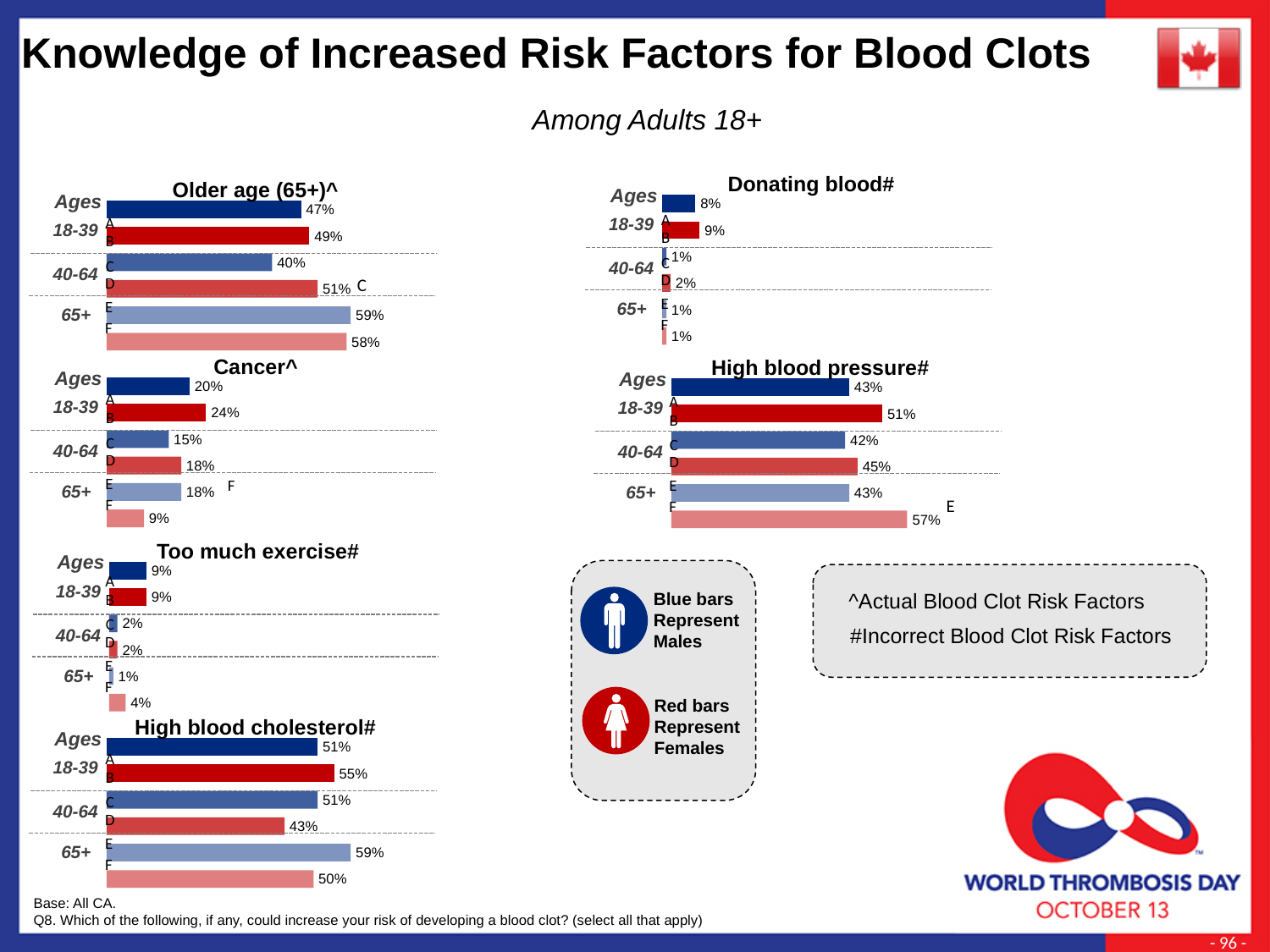
According to the legend box, what do the red bars represent? Females In the 'Older age (65+)' chart, what percentage of males aged 65+ identified older age as a risk factor? 59% In the 'High blood cholesterol' chart, which age-and-gender bar has the highest value? Males 65+ (59%) In the 'Donating blood' chart, what is the value for females aged 18-39? 9% In the 'High blood pressure' chart, what is the value for females aged 65+? 57% What type of chart is used for 'High blood cholesterol'? Bar chart In the 'Older age (65+)' chart, what is the difference between females aged 40-64 and males aged 40-64? 11% How many charts of risk factors are shown on the slide? 6 In the 'Cancer' chart, what is the value for females aged 65+? 9% In the 'High blood pressure' chart, which is larger: males 18-39 or females 18-39? Females 18-39 (51%) In the 'Too much exercise' chart, what is the value for females aged 65+? 4% In the 'Cancer' chart, which bar has the lowest value? Females 65+ (9%)